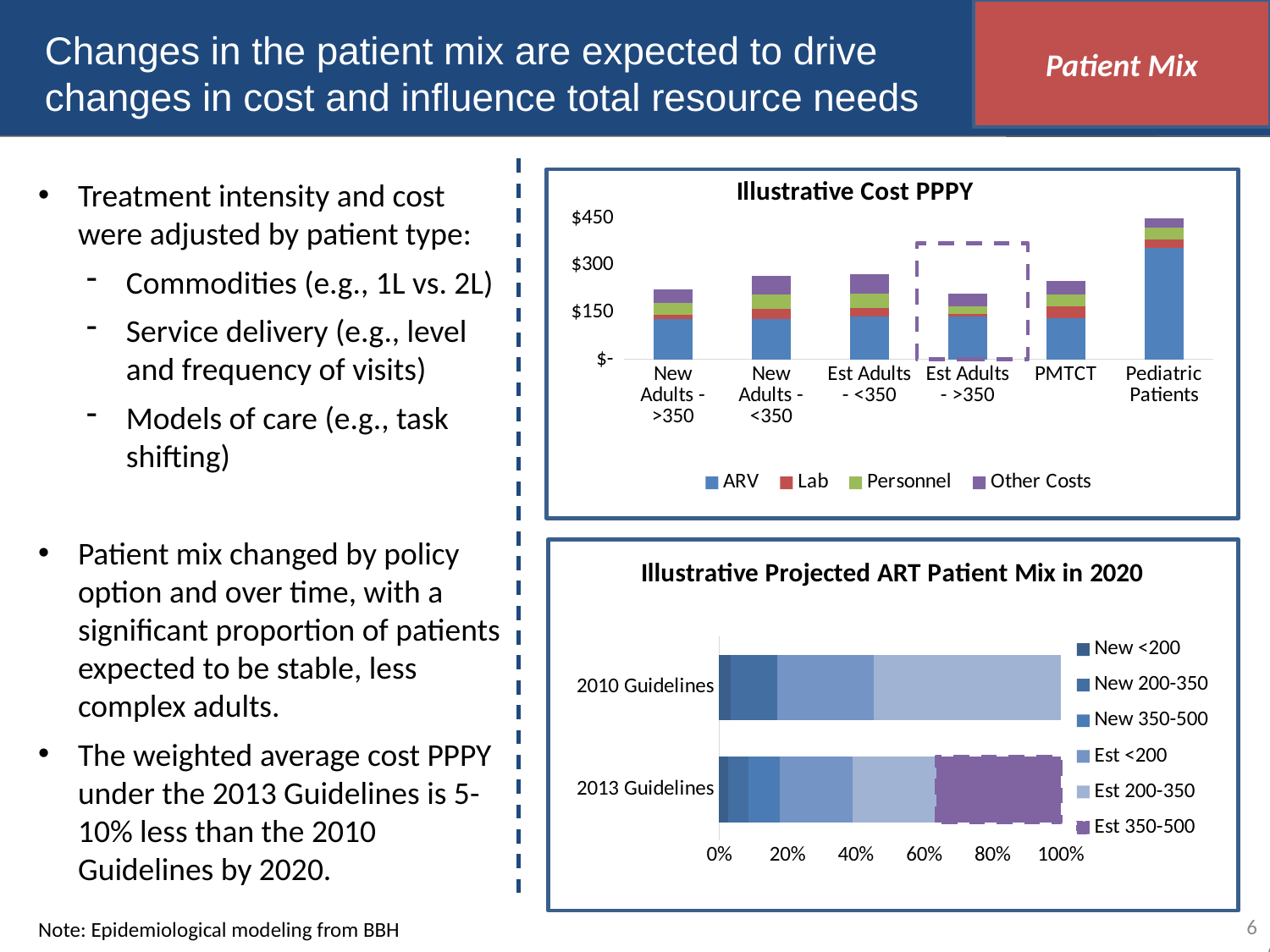
In the 'Illustrative Cost PPPY' chart, is the total cost for Est Adults - >350 greater or less than $300? less How many series does the legend of the 'Illustrative Cost PPPY' chart list? 4 In the 'Illustrative Projected ART Patient Mix in 2020' chart, is the Est 350-500 share for 2013 Guidelines greater or less than 20%? greater How many patient categories are shown on the x axis of the 'Illustrative Cost PPPY' chart? 6 What kind of chart is the 'Illustrative Cost PPPY' chart? Stacked bar chart What kind of chart is the 'Illustrative Projected ART Patient Mix in 2020' chart? Stacked bar chart How many series does the legend of the 'Illustrative Projected ART Patient Mix in 2020' chart list? 6 In the 'Illustrative Cost PPPY' chart, is the total cost for Pediatric Patients greater or less than $300? greater In the 'Illustrative Cost PPPY' chart, which has the larger total cost: Pediatric Patients or PMTCT? Pediatric Patients How many categories are shown on the 'Illustrative Projected ART Patient Mix in 2020' chart? 2 In the 'Illustrative Cost PPPY' chart, which series is shown in blue? ARV In the 'Illustrative Cost PPPY' chart, which patient category has the highest total cost? Pediatric Patients